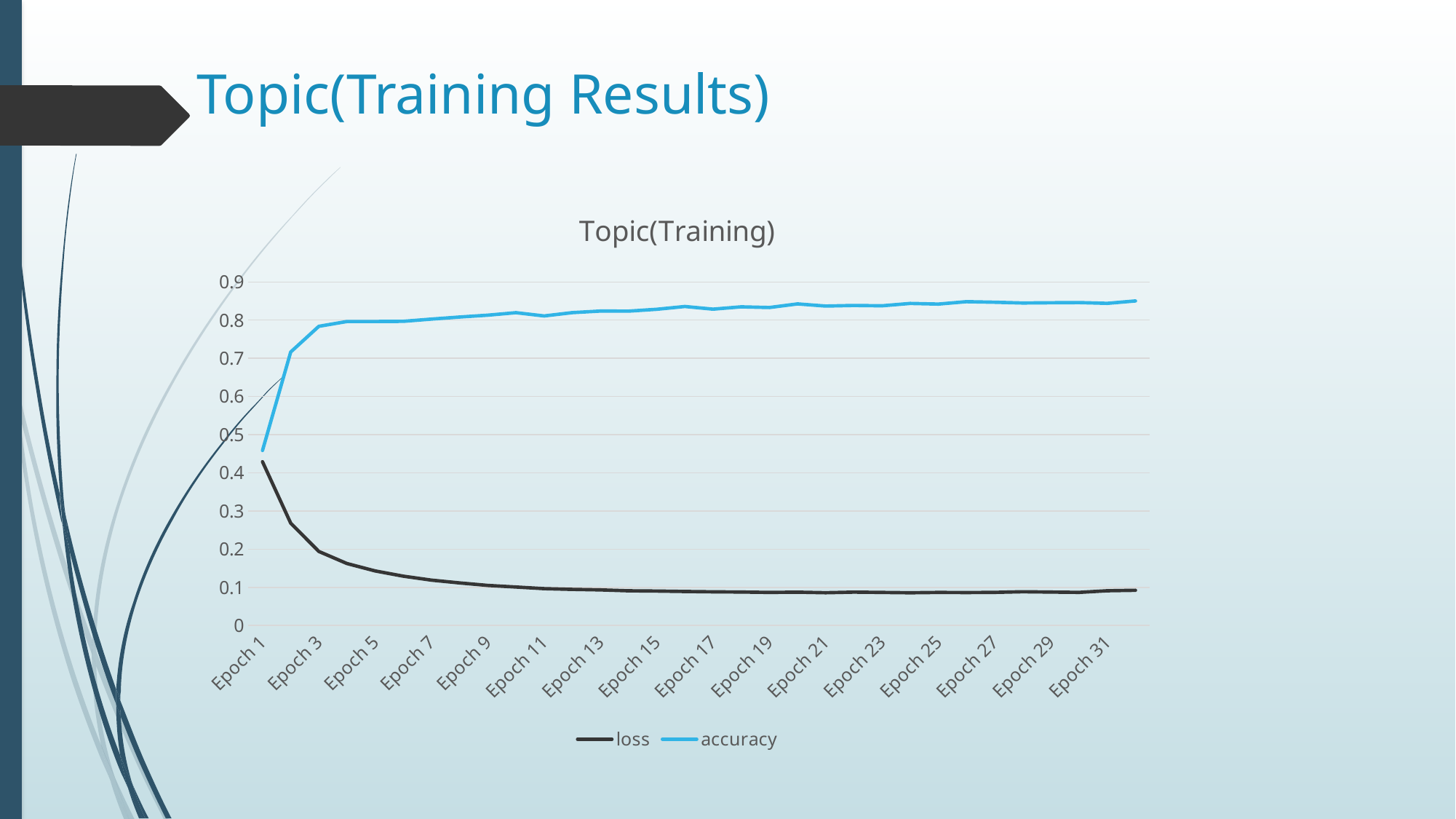
At Epoch 31, which is larger, the loss value or the accuracy value? accuracy Does the loss series rise or fall from Epoch 1 to Epoch 31? fall Is the loss value at Epoch 31 greater or less than 0.2? less At which epoch is the accuracy value lowest? Epoch 1 At which epoch is the loss value highest? Epoch 1 Is the accuracy value at Epoch 31 greater or less than 0.8? greater What is the title of the chart? Topic(Training) Which series is drawn in light blue? accuracy How many series does the legend list? 2 What kind of chart is shown on the slide? line chart Is the loss value at Epoch 1 greater or less than 0.3? greater Does the accuracy series rise or fall from Epoch 1 to Epoch 31? rise